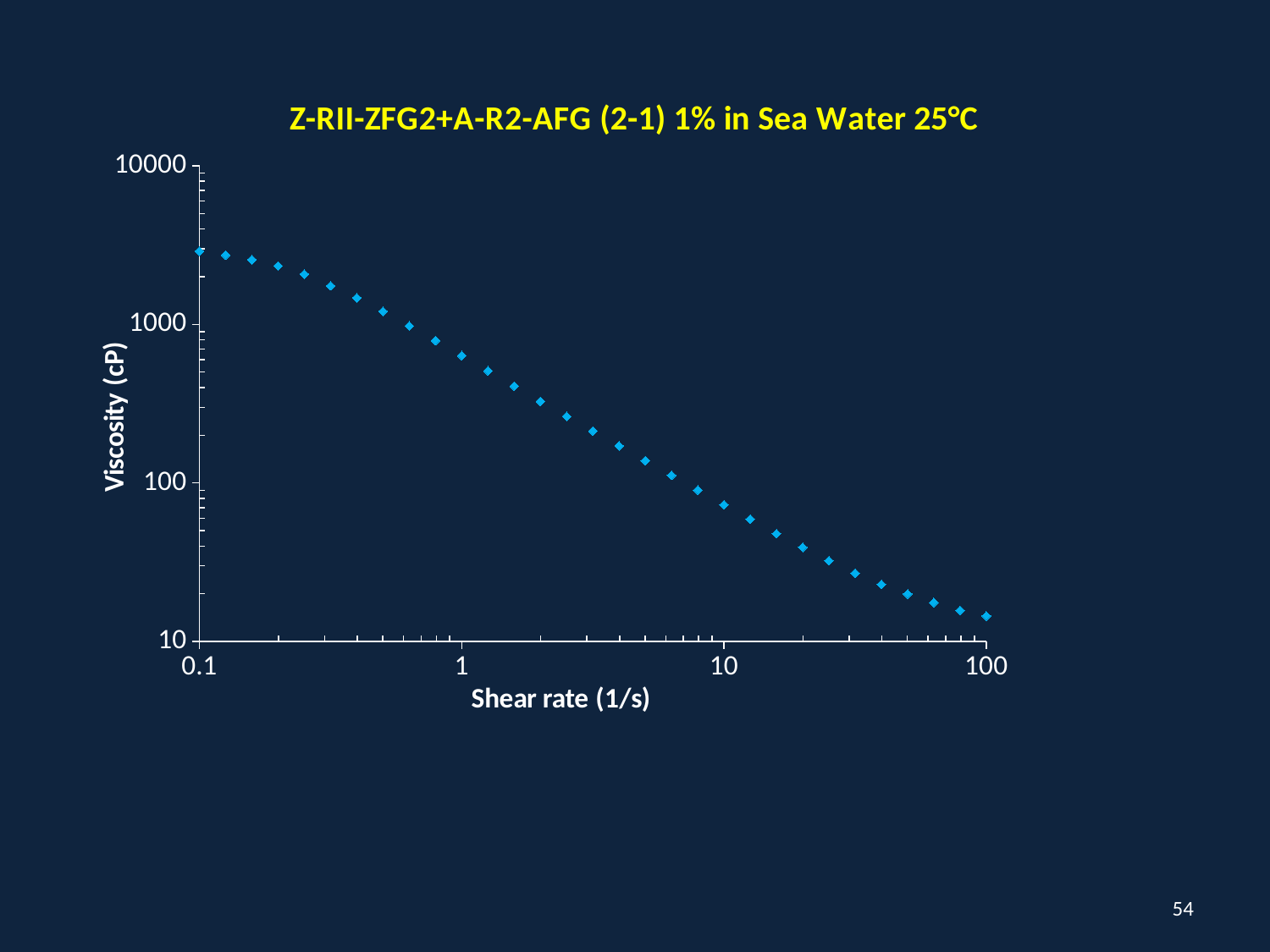
Is the viscosity at a shear rate of 0.1 1/s greater or less than 1000 cP? greater Is the viscosity at a shear rate of 10 1/s greater or less than 100 cP? less Is the viscosity at a shear rate of 1 1/s greater or less than 100 cP? greater At which shear rate is the viscosity lowest? 100 1/s At which shear rate is the viscosity highest? 0.1 1/s What kind of chart is shown on the slide? Scatter chart What is the label of the y axis? Viscosity (cP) Which has the larger viscosity: a shear rate of 0.1 1/s or 100 1/s? 0.1 1/s Does viscosity rise or fall as shear rate increases along the x axis? Fall What is the title of the chart? Z-RII-ZFG2+A-R2-AFG (2-1) 1% in Sea Water 25°C